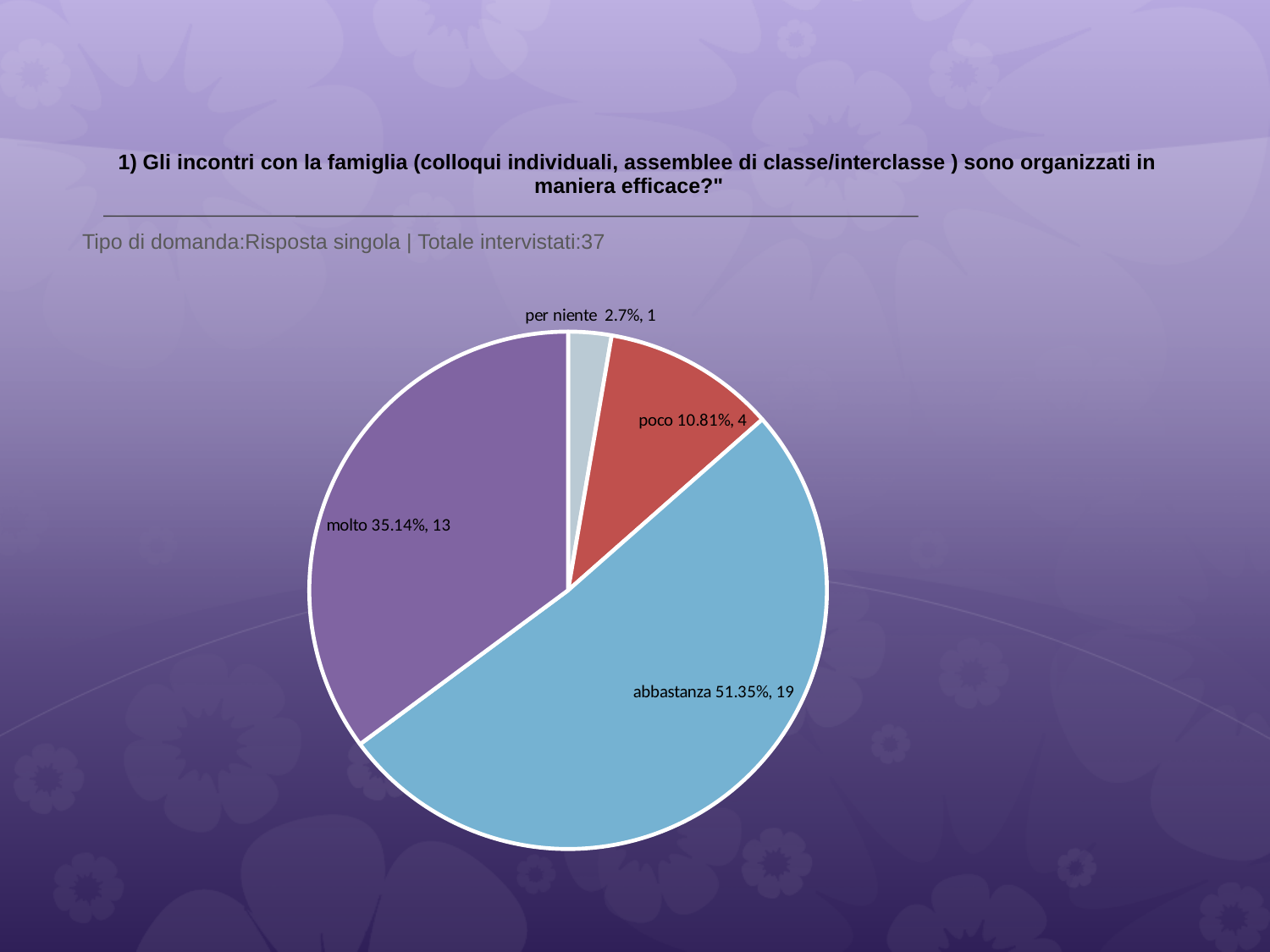
How many slices does the pie chart have? 4 Which category has the smallest slice? per niente What percentage share does the 'abbastanza' slice have? 51.35% Which category has the largest slice? abbastanza How many respondents answered 'per niente'? 1 How many respondents answered 'molto'? 13 What is the difference in respondent count between 'abbastanza' and 'molto'? 6 What colour is the 'abbastanza' slice? blue What percentage share does the 'poco' slice have? 10.81% What kind of chart is shown on the slide? pie chart Which has more respondents, 'poco' or 'molto'? molto What is the total number of respondents shown on the slide? 37